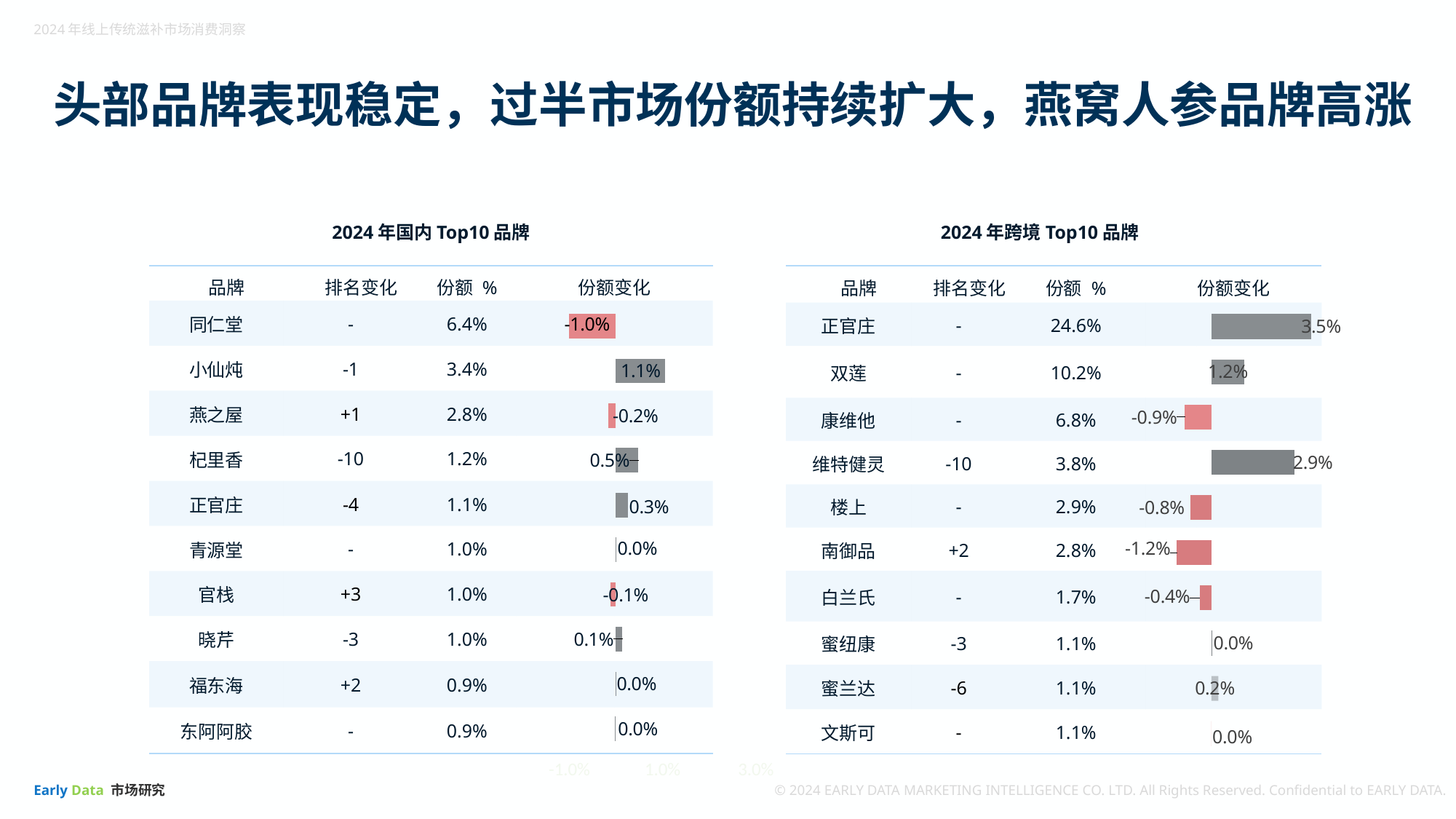
In the 2024 年国内 Top10 品牌 chart, what is the difference between the 份额变化 of 杞里香 and 正官庄? 0.2% In the 2024 年国内 Top10 品牌 chart, what is the 份额变化 value for 小仙炖? 1.1% In the 2024 年跨境 Top10 品牌 chart, which has a larger 份额变化, 双莲 or 维特健灵? 维特健灵 In the 2024 年跨境 Top10 品牌 chart, which brand has the highest 份额变化? 正官庄 In the 2024 年国内 Top10 品牌 chart, which brand has the lowest 份额变化? 同仁堂 In the 2024 年跨境 Top10 品牌 chart, what is the 份额变化 value for 南御品? -1.2% In the 2024 年国内 Top10 品牌 chart, what is the 份额变化 value for 同仁堂? -1.0% In the 2024 年跨境 Top10 品牌 chart, what is the 份额变化 value for 正官庄? 3.5% In the 2024 年跨境 Top10 品牌 chart, which brand has the lowest 份额变化? 南御品 In the 2024 年国内 Top10 品牌 chart, which brand has the highest 份额变化? 小仙炖 In the 2024 年跨境 Top10 品牌 chart, what is the difference between the 份额变化 of 正官庄 and 维特健灵? 0.6% How many brands are shown in the 2024 年国内 Top10 品牌 chart? 10